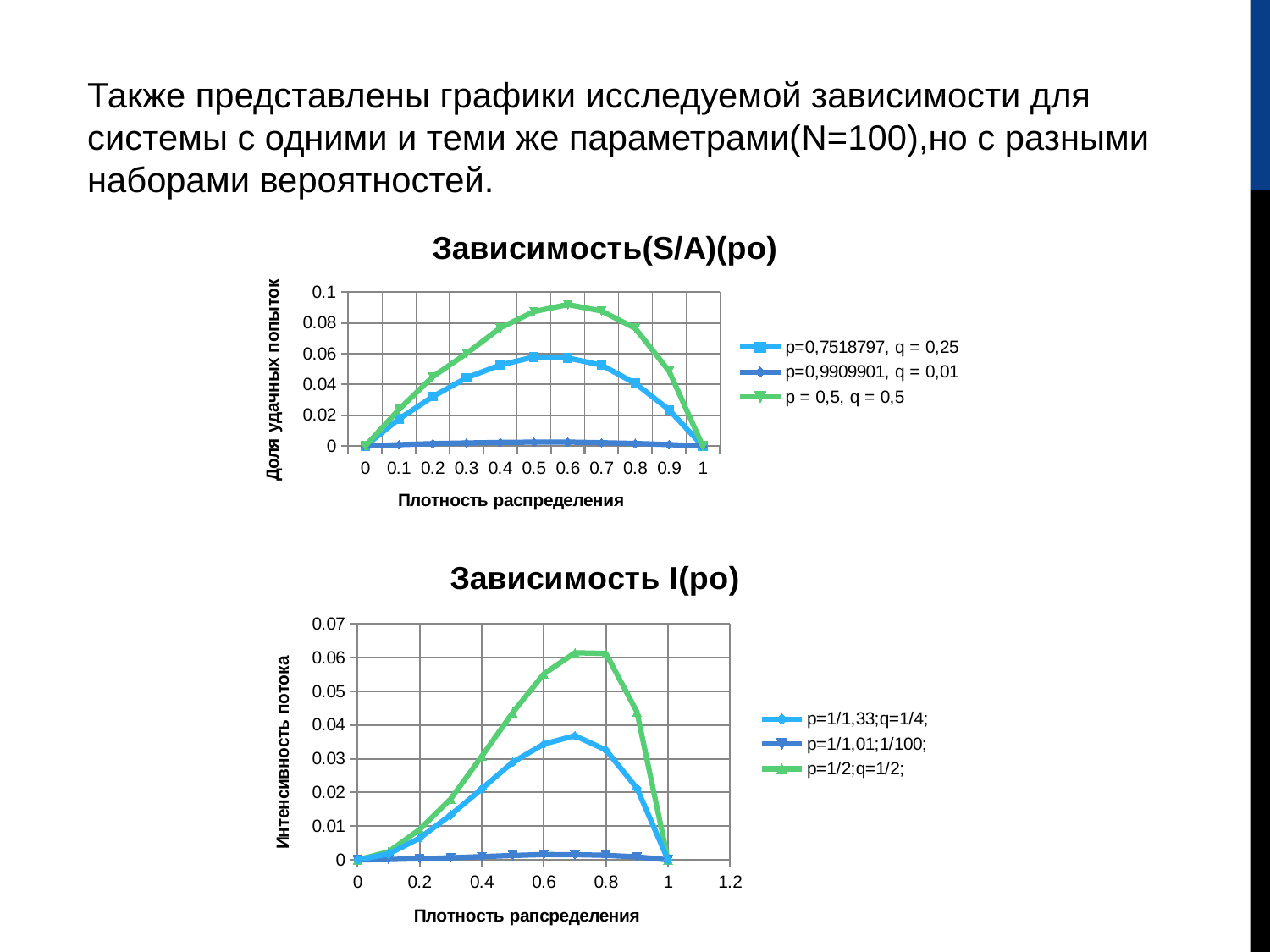
What is the y-axis title of the bottom chart "Зависимость I(ро)"? Интенсивность потока In the top chart "Зависимость(S/A)(ро)", how many series does the legend list? 3 In the top chart "Зависимость(S/A)(ро)", what is the value of the series p = 0,5, q = 0,5 at x = 1? 0 In the top chart "Зависимость(S/A)(ро)", is the value of the series p=0,7518797, q = 0,25 at x = 0.5 greater or less than 0.04? greater In the bottom chart "Зависимость I(ро)", which series has the lowest values across the x axis? p=1/1,01;1/100; In the top chart "Зависимость(S/A)(ро)", is the value of the series p = 0,5, q = 0,5 at x = 0.6 greater or less than 0.08? greater In the bottom chart "Зависимость I(ро)", how many series does the legend list? 3 In the top chart "Зависимость(S/A)(ро)", at x = 0.3, which series has the larger value: p = 0,5, q = 0,5 or p=0,7518797, q = 0,25? p = 0,5, q = 0,5 What kind of chart is the top chart titled "Зависимость(S/A)(ро)"? line chart In the bottom chart "Зависимость I(ро)", is the value of the series p=1/2;q=1/2; at x = 0.7 greater or less than 0.05? greater In the top chart "Зависимость(S/A)(ро)", which series reaches the highest value? p = 0,5, q = 0,5